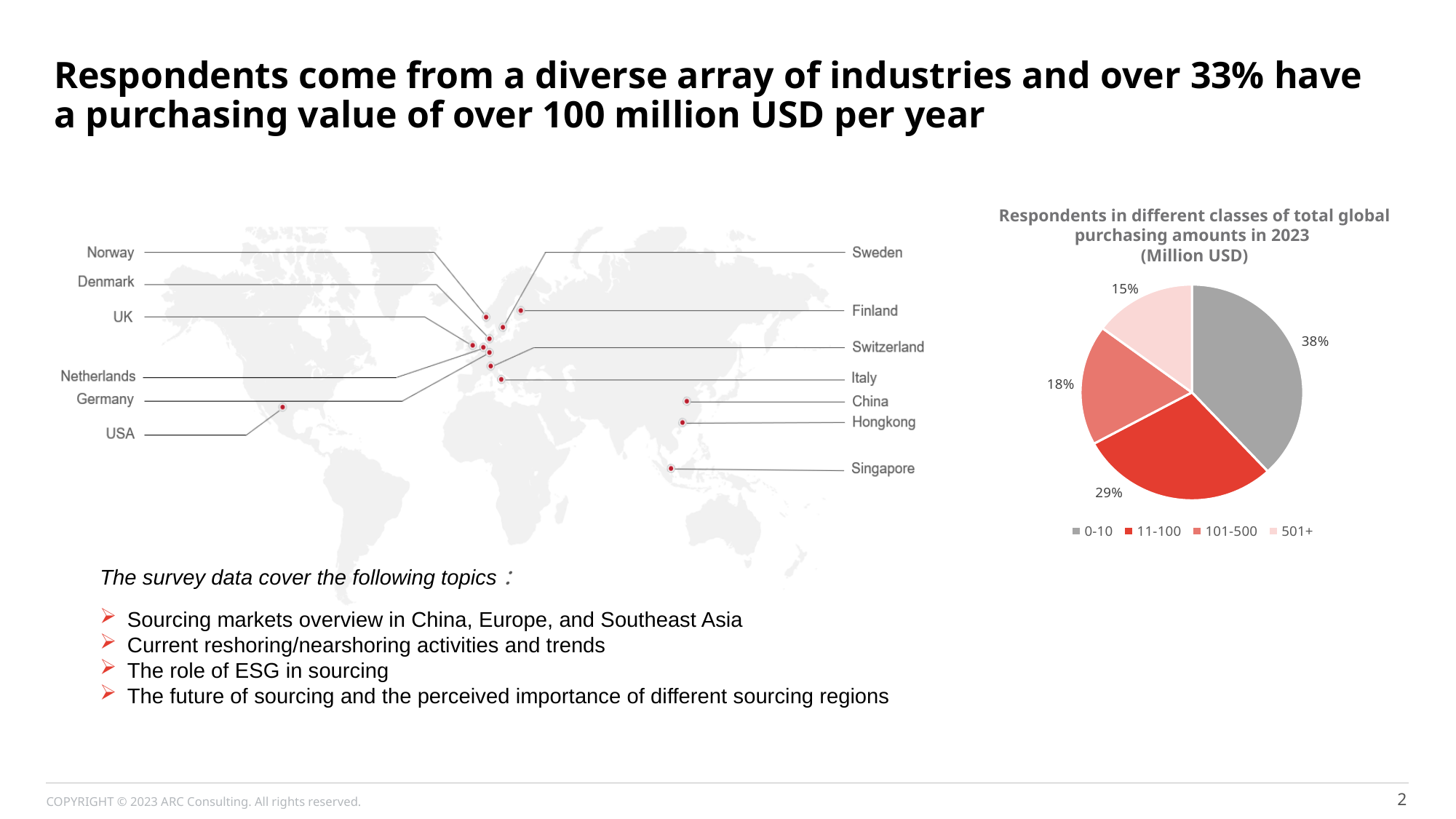
What share of respondents falls in the 501+ million USD purchasing class? 15% What is the difference in percentage points between the 0-10 class and the 11-100 class? 9 percentage points What is the combined share of respondents in the 101-500 and 501+ classes? 33% Which has a larger share of respondents, the 101-500 class or the 501+ class? 101-500 What type of chart is used to show respondents in different classes of total global purchasing amounts in 2023? Pie chart Which purchasing class has the largest share of respondents? 0-10 What share of respondents falls in the 11-100 million USD purchasing class? 29% What is the title of the pie chart? Respondents in different classes of total global purchasing amounts in 2023 (Million USD) What share of respondents falls in the 0-10 million USD purchasing class? 38% Which purchasing class has the smallest share of respondents? 501+ What share of respondents falls in the 101-500 million USD purchasing class? 18% How many purchasing classes are shown in the pie chart? 4